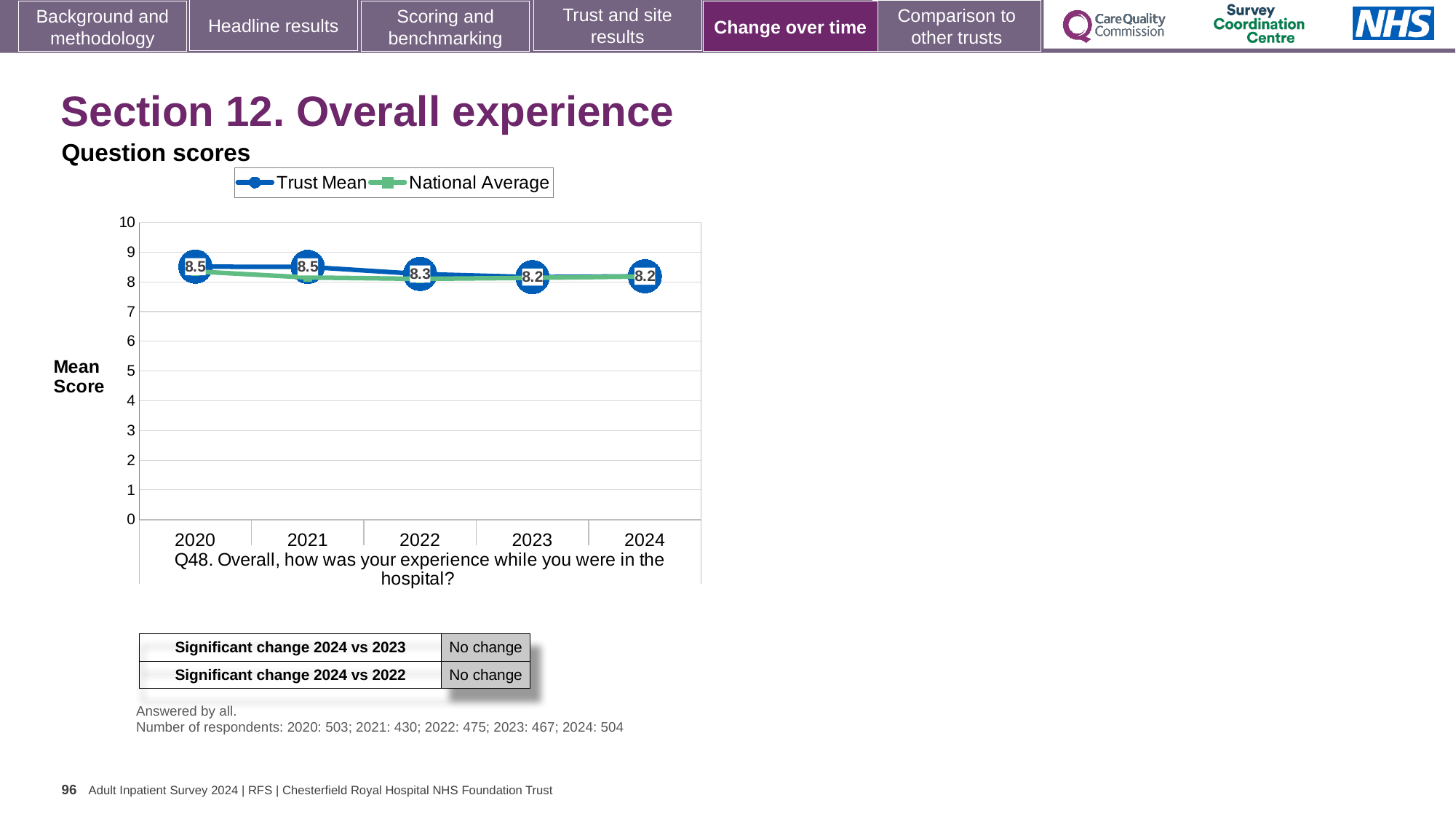
What are the two series named in the legend? Trust Mean and National Average What is the Trust Mean score for 2024? 8.2 Does the Trust Mean score rise or fall from 2020 to 2024? fall What is the Trust Mean score for 2022? 8.3 What is the Trust Mean score for 2023? 8.2 How many series does the legend list? 2 Is the National Average value for 2020 greater or less than 8? greater What kind of chart is shown? line chart How many years are plotted on the x axis? 5 What is the Trust Mean score for 2020? 8.5 What is the difference between the Trust Mean score in 2020 and in 2024? 0.3 Which year has the larger Trust Mean score, 2021 or 2022? 2021